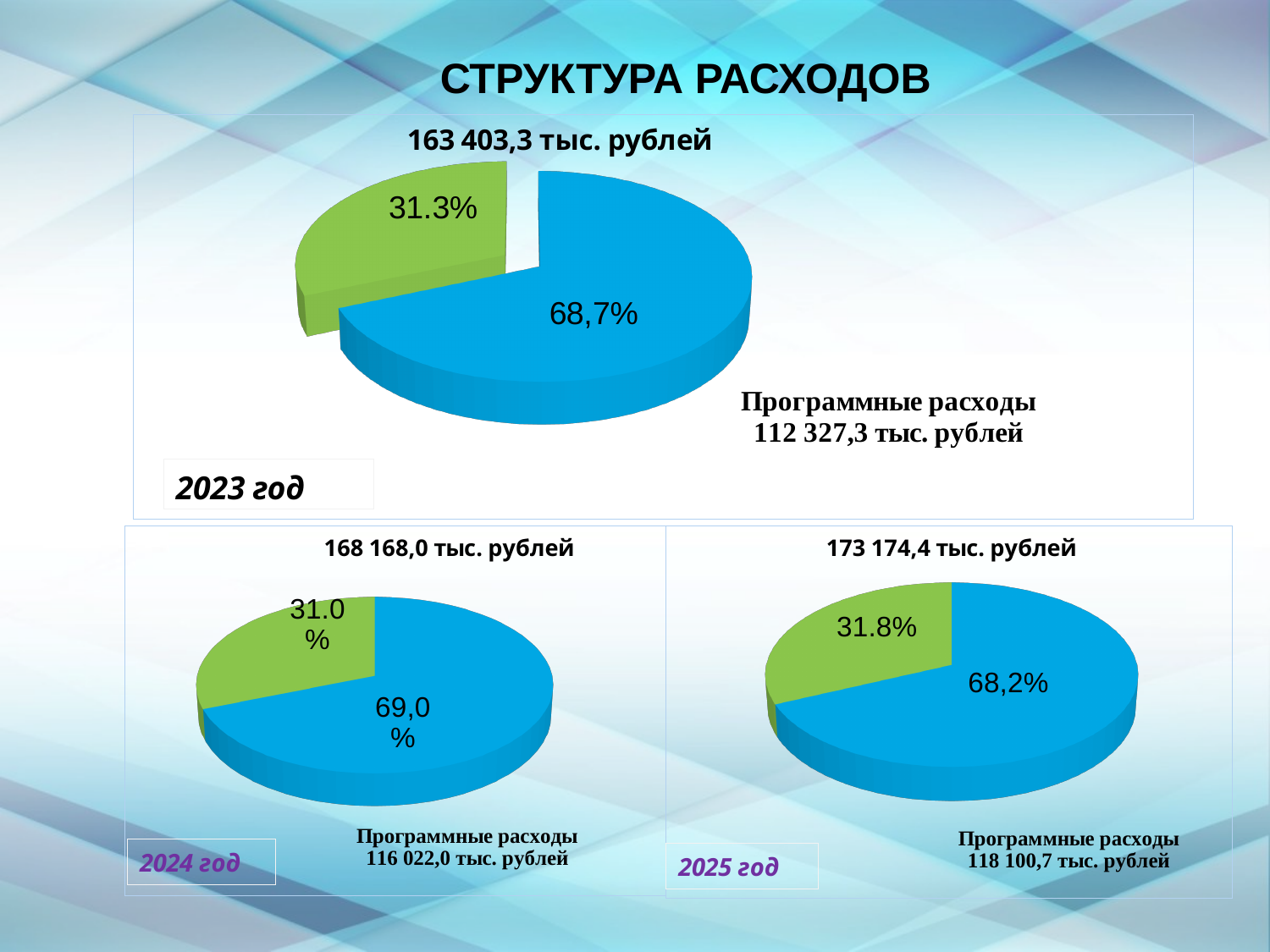
In the 2025 год pie chart, what is the difference in percentage points between the blue slice and the green slice? 36.4 How many pie charts are shown on the slide? 3 In the 2025 год pie chart, what percentage is shown on the green slice? 31.8% In the 2025 год pie chart, which slice is larger, the blue one or the green one? the blue one What is the amount of Программные расходы shown for the 2024 год chart? 116 022,0 тыс. рублей How many slices does the 2024 год pie chart have? 2 What total amount is shown above the 2023 год pie chart? 163 403,3 тыс. рублей What is the amount of Программные расходы shown for the 2025 год chart? 118 100,7 тыс. рублей In the 2023 год pie chart, what percentage is shown on the green slice? 31.3% What kind of chart is used for the 2023 год data? pie chart In the 2023 год pie chart, what percentage is shown on the blue slice? 68,7% In the 2024 год pie chart, what percentage is shown on the blue slice? 69,0%